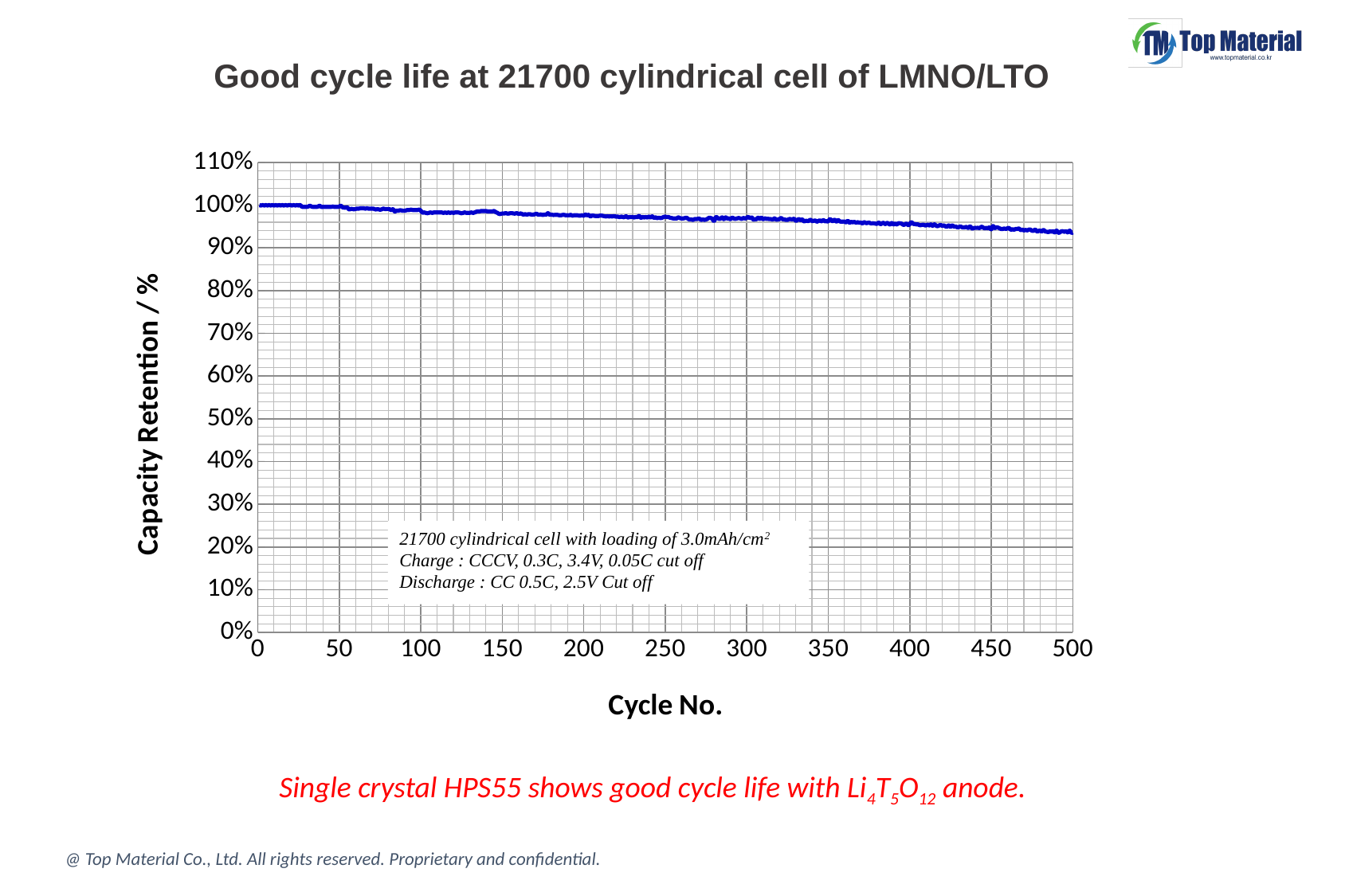
What is the label of the x axis? Cycle No. What is the highest tick value shown on the y axis? 110% What is the highest value shown on the x axis? 500 What is the label of the y axis? Capacity Retention / % Is the capacity retention at cycle 500 greater or less than 90%? greater Is the capacity retention at cycle 500 greater or less than 100%? less Is the capacity retention at cycle 250 greater or less than 90%? greater Which has the lower capacity retention: cycle 100 or cycle 500? cycle 500 Does capacity retention rise or fall as the cycle number increases from 0 to 500? fall Which has the higher capacity retention: cycle 50 or cycle 450? cycle 50 What kind of chart is shown on the slide? line chart